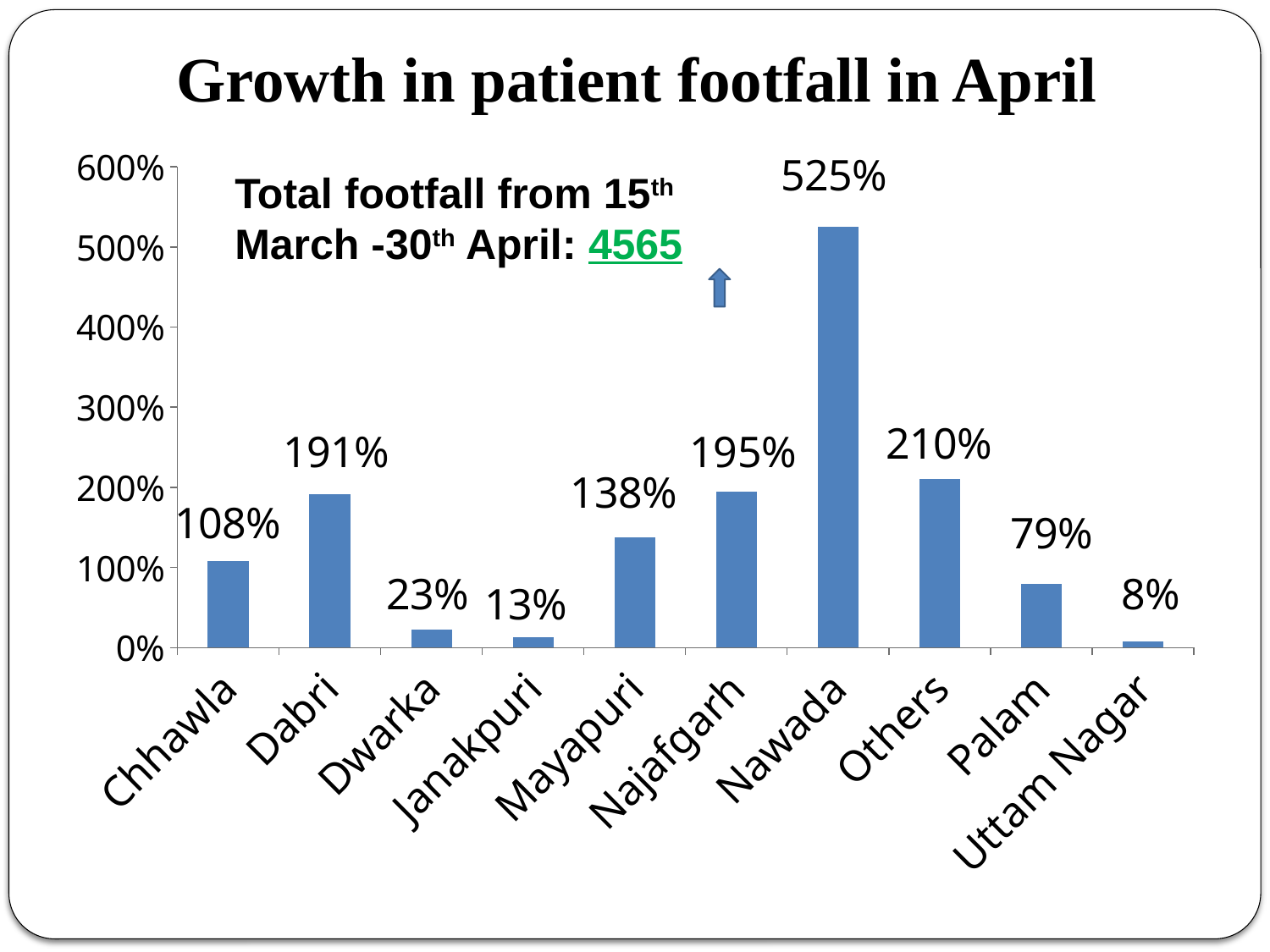
What is the growth in patient footfall for Mayapuri? 138% How many categories are shown on the x axis? 10 What is the growth in patient footfall for Dabri? 191% What is the title of the chart? Growth in patient footfall in April What is the growth in patient footfall for Nawada? 525% Which category has the lowest growth in patient footfall? Uttam Nagar Which category has the highest growth in patient footfall? Nawada What kind of chart is shown on the slide? Bar chart Is the value for Chhawla greater or less than 100%? greater What is the growth in patient footfall for Uttam Nagar? 8% What is the difference between the growth for Others and the growth for Palam? 131% Which has a higher growth in patient footfall, Najafgarh or Dabri? Najafgarh